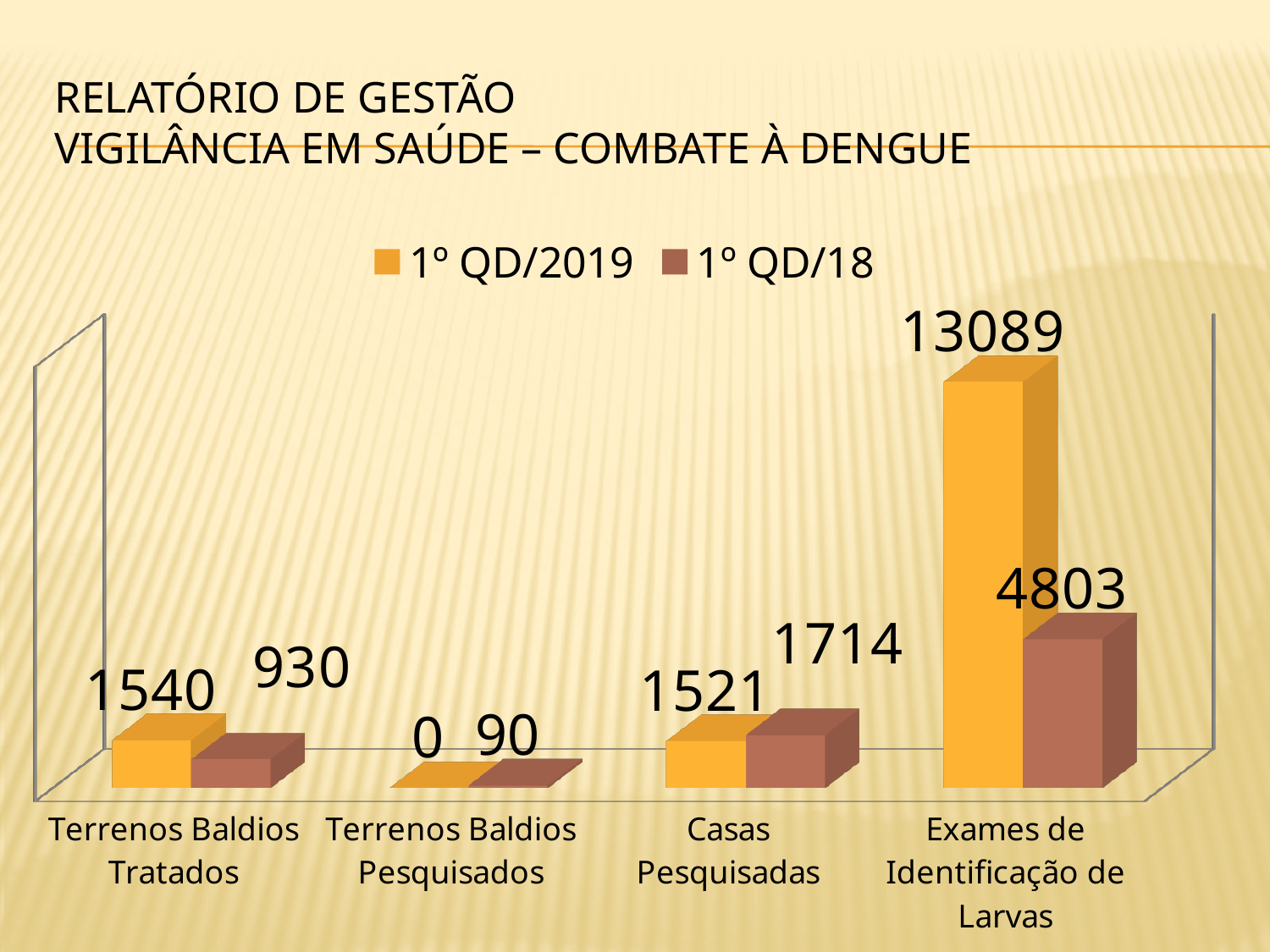
Which category has the lowest value in the 1º QD/18 series? Terrenos Baldios Pesquisados What is the value for Exames de Identificação de Larvas in the 1º QD/18 series? 4803 For Terrenos Baldios Tratados, which series has the larger value, 1º QD/2019 or 1º QD/18? 1º QD/2019 Which category has the highest value in the 1º QD/2019 series? Exames de Identificação de Larvas What is the value for Terrenos Baldios Pesquisados in the 1º QD/2019 series? 0 What is the difference between the 1º QD/2019 and 1º QD/18 values for Exames de Identificação de Larvas? 8286 How many categories are shown on the x axis? 4 What is the value for Terrenos Baldios Tratados in the 1º QD/2019 series? 1540 What kind of chart is shown on the slide? Bar chart What is the value for Casas Pesquisadas in the 1º QD/18 series? 1714 How many series does the legend list? 2 What is the difference between the 1º QD/18 and 1º QD/2019 values for Casas Pesquisadas? 193